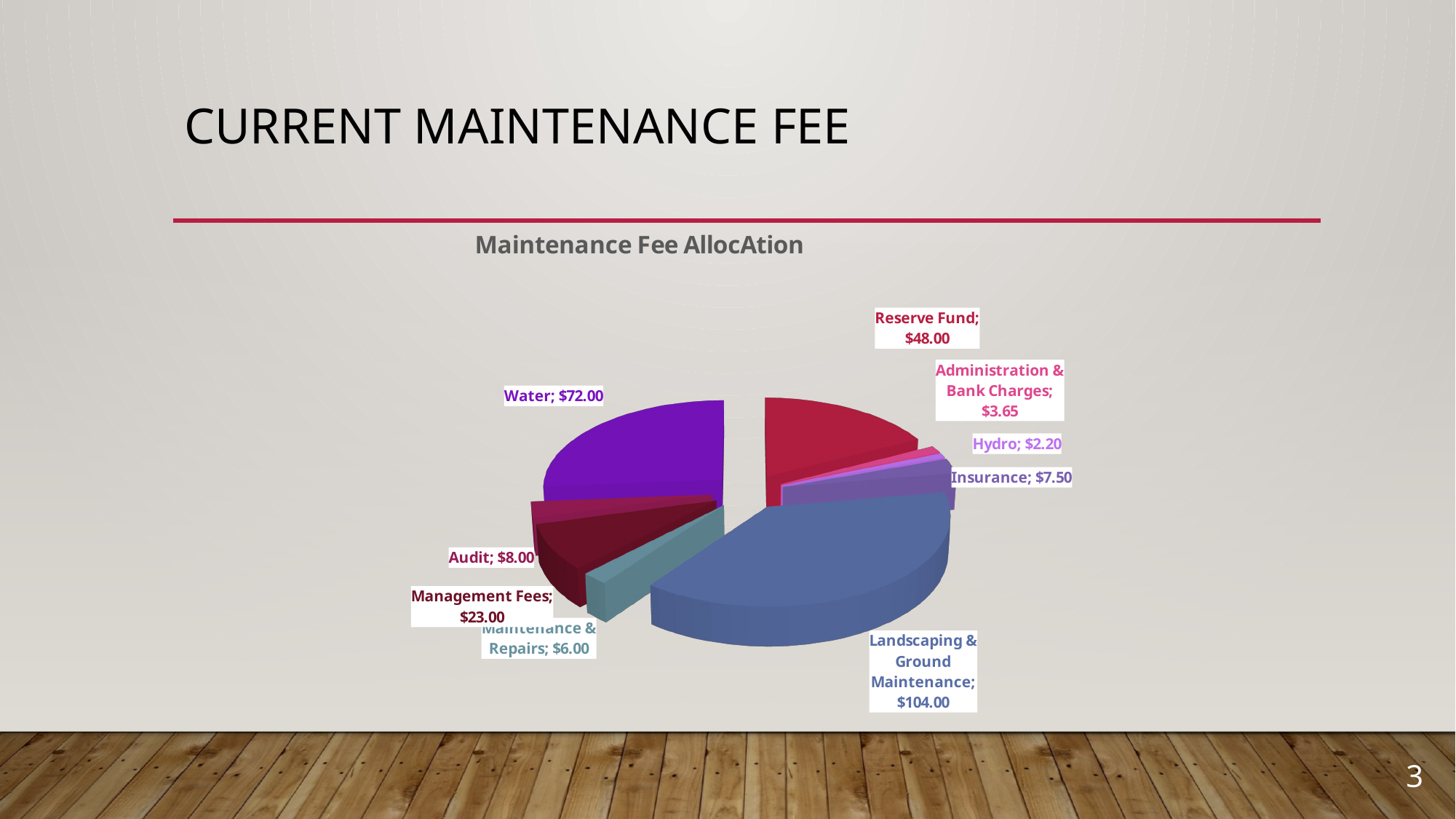
What is the value for Water in the pie chart? $72.00 What kind of chart is shown on the slide? Pie chart What is the difference between the Reserve Fund value and the Management Fees value? $25.00 What is the value for Landscaping & Ground Maintenance in the Maintenance Fee Allocation pie chart? $104.00 Which is larger in the pie chart, Audit or Insurance? Audit Which category has the smallest slice in the pie chart? Hydro What is the value for Hydro in the pie chart? $2.20 What is the total of all the values shown in the pie chart? $274.35 What is the title of the chart on the slide? Maintenance Fee AllocAtion How many categories are shown in the pie chart? 9 Which category has the largest slice in the pie chart? Landscaping & Ground Maintenance What is the value for Administration & Bank Charges in the pie chart? $3.65